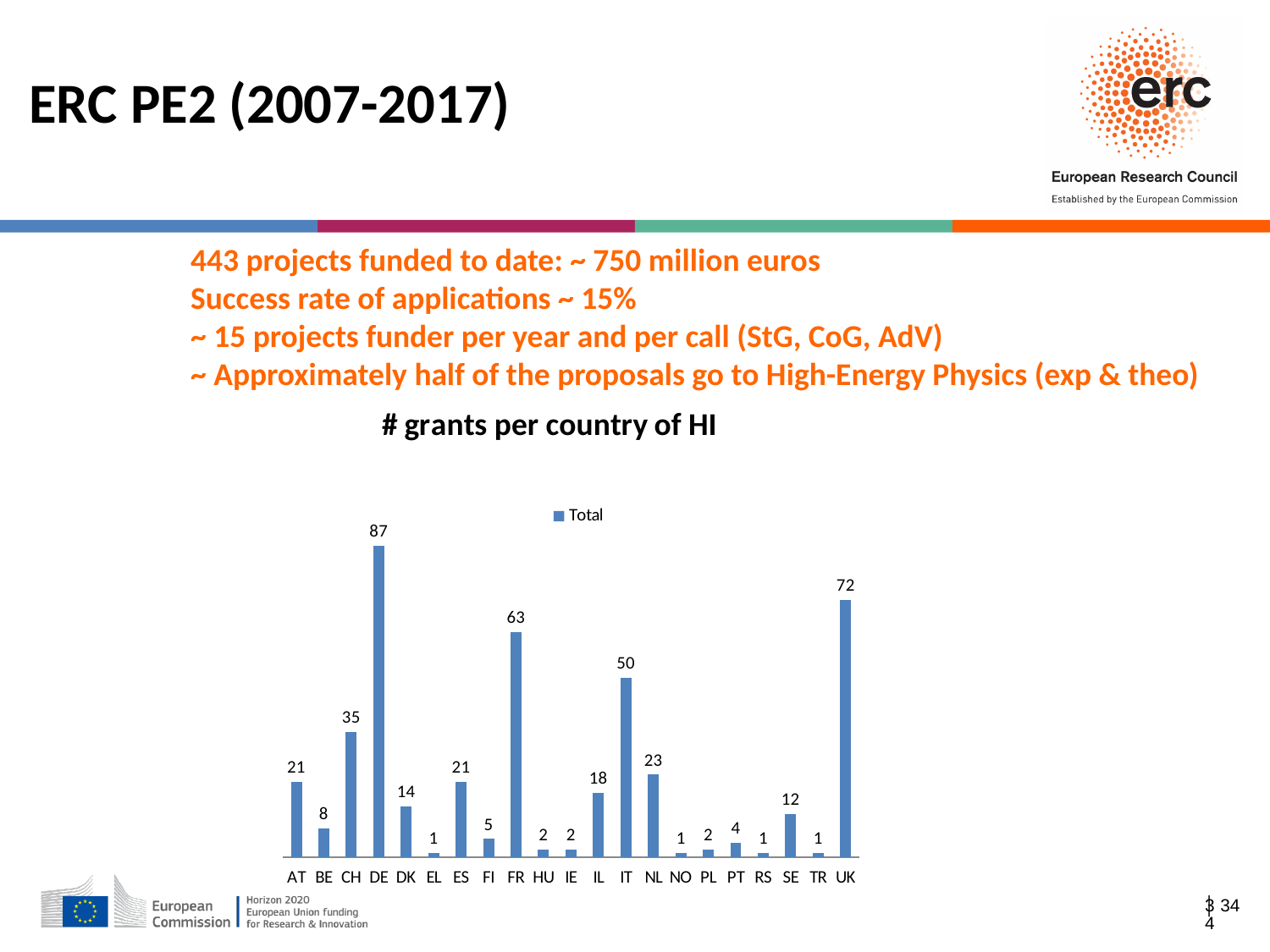
How many series does the chart legend list? 1 What is the difference between the values for DE and UK? 15 Which has a larger value, SE or DK? DK Which has a larger value, FR or IT? FR What is the value for UK in the chart? 72 What is the value for IT in the chart? 50 What is the value for FR in the chart? 63 What kind of chart is shown on the slide? Bar chart Which country has the highest value in the chart? DE What is the value for DE in the chart? 87 How many countries are shown on the x axis of the chart? 21 What is the difference between the values for CH and NL? 12